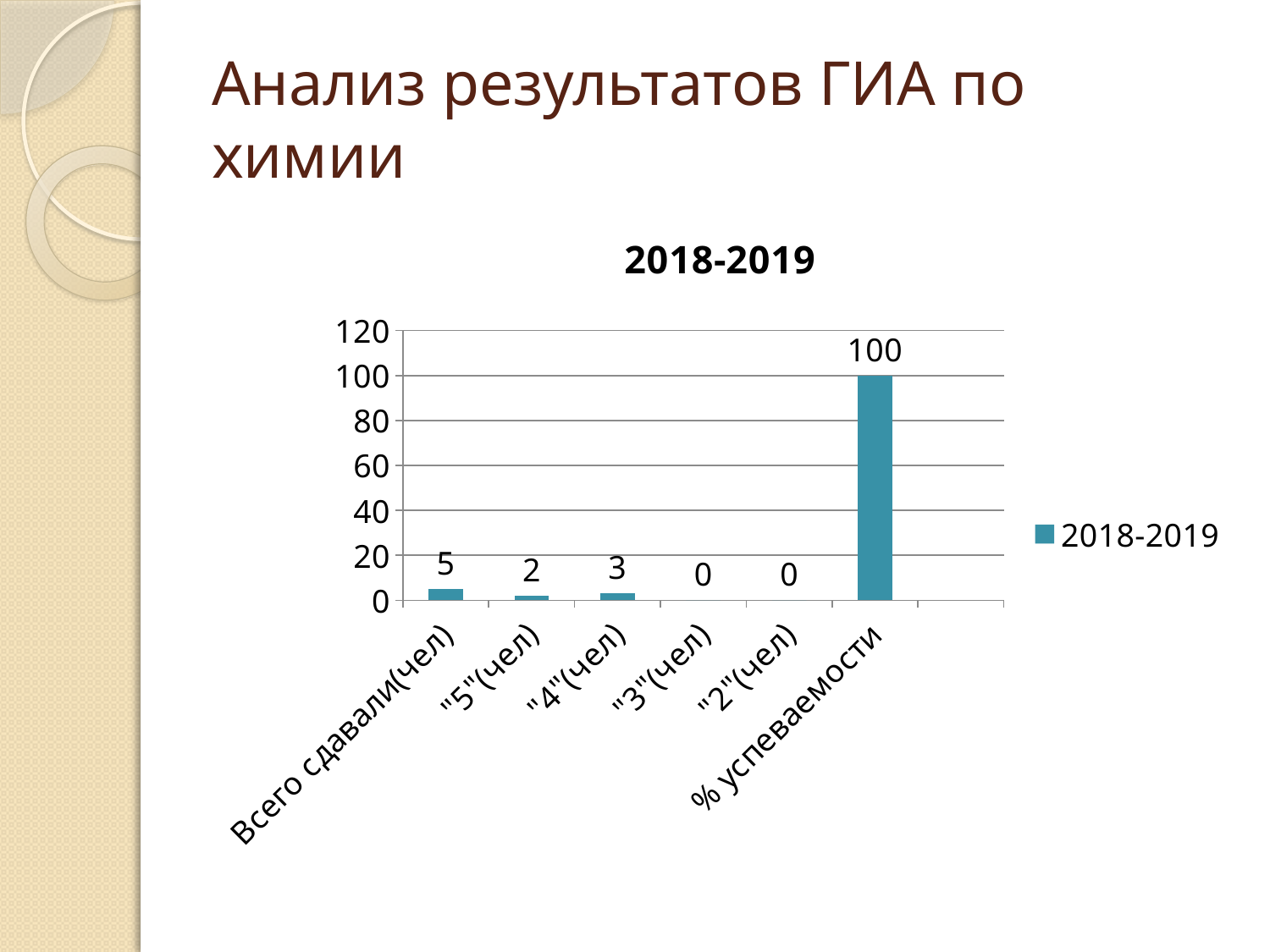
Which is larger, the value for ""4"(чел)" or the value for ""5"(чел)"? "4"(чел) How many categories are shown on the x axis? 6 What is the difference between the values for ""4"(чел)" and ""5"(чел)"? 1 What is the value for ""4"(чел)"? 3 What kind of chart is shown? bar chart What is the value for "% успеваемости"? 100 Which category has the highest value? % успеваемости What is the title of the chart? 2018-2019 Is the value for "% успеваемости" greater or less than 80? greater How many series does the legend list? 1 What is the value for "Всего сдавали(чел)"? 5 What is the value for ""5"(чел)"? 2